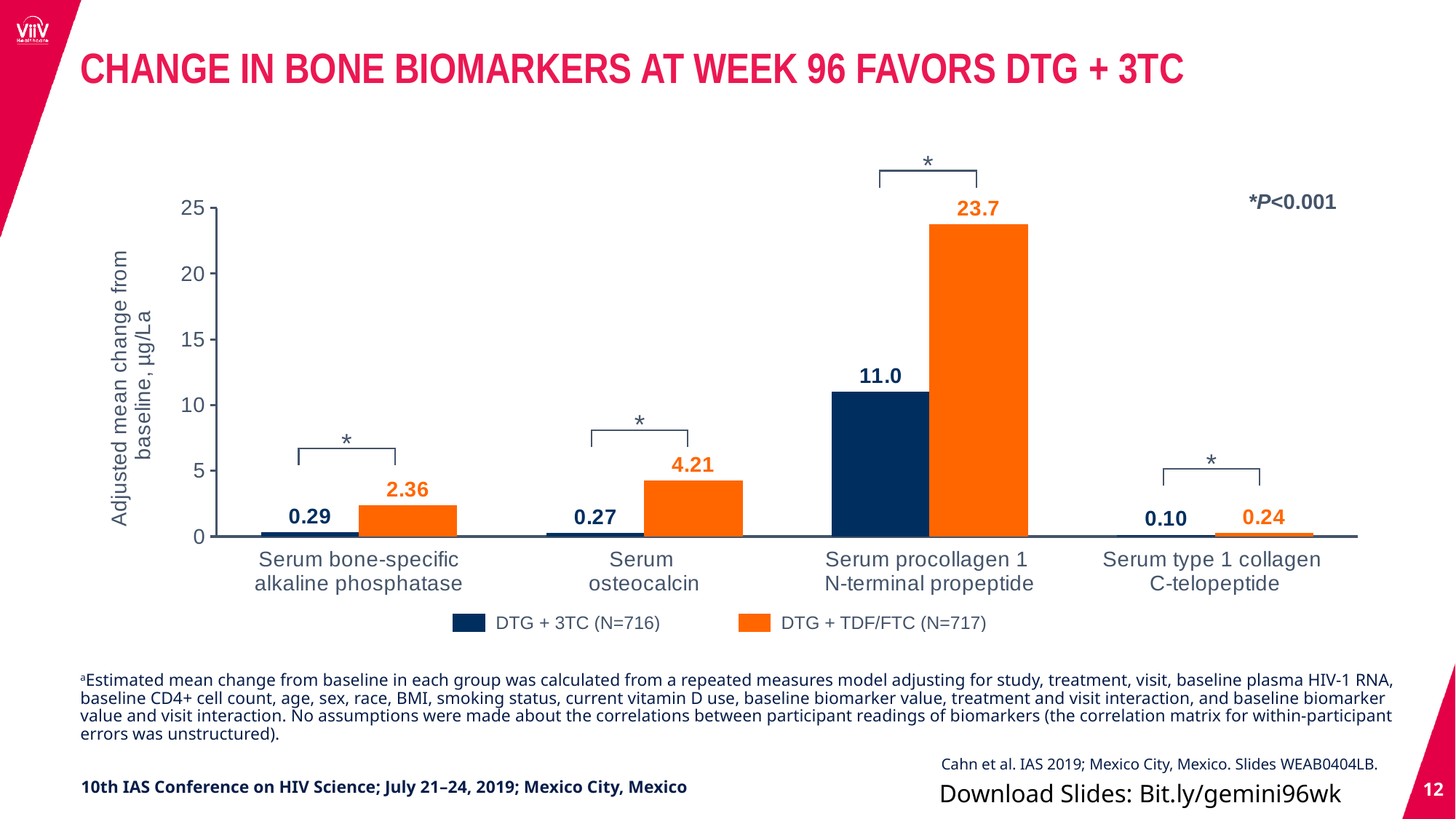
Is the DTG + 3TC value for serum procollagen 1 N-terminal propeptide greater or less than 10? greater What type of chart is shown on the slide? Bar chart What is the difference between the DTG + TDF/FTC and DTG + 3TC values for serum osteocalcin? 3.94 What is the value for DTG + TDF/FTC in serum bone-specific alkaline phosphatase? 2.36 How many biomarker categories are shown on the x axis? 4 Which biomarker has the highest value for the DTG + 3TC group? Serum procollagen 1 N-terminal propeptide How many series does the legend list? 2 What is the difference between the DTG + TDF/FTC and DTG + 3TC values for serum procollagen 1 N-terminal propeptide? 12.7 For serum type 1 collagen C-telopeptide, which group has the larger value, DTG + 3TC or DTG + TDF/FTC? DTG + TDF/FTC What is the adjusted mean change from baseline for DTG + 3TC in serum osteocalcin? 0.27 Which biomarker has the lowest value for the DTG + TDF/FTC group? Serum type 1 collagen C-telopeptide What is the adjusted mean change from baseline for DTG + TDF/FTC in serum procollagen 1 N-terminal propeptide? 23.7